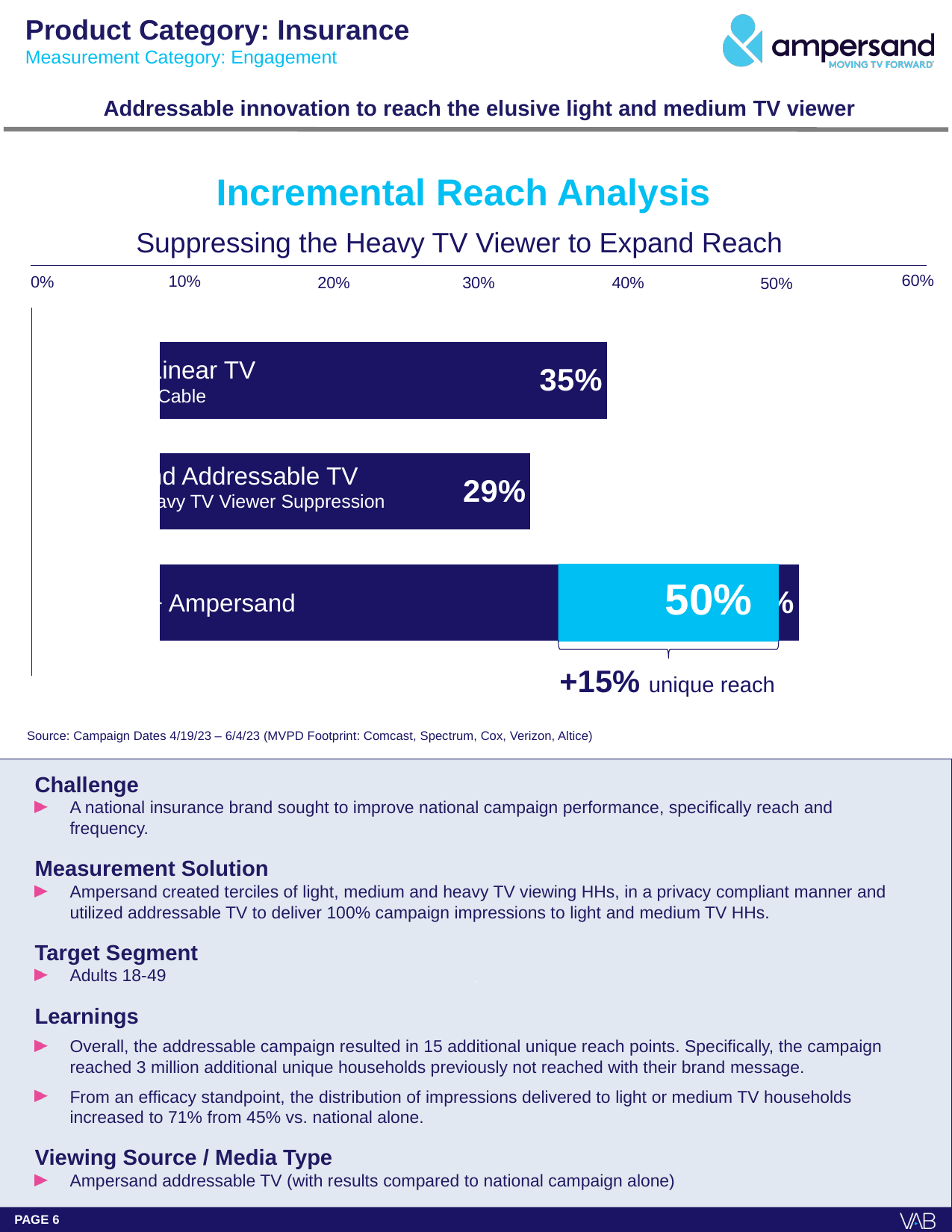
What is the difference between the Linear TV bar (35%) and the Addressable TV bar (29%)? 6% What kind of chart is shown on the slide? Bar chart What incremental unique reach is annotated below the Ampersand bar? +15% unique reach Is the value for the Ampersand bar greater or less than 40%? greater Which bar has the highest value? Ampersand What value is shown on the Addressable TV (Heavy TV Viewer Suppression) bar? 29% What value is shown on the Linear TV (Cable) bar? 35% How many bars are plotted in the chart? 3 What is the difference between the Ampersand bar (50%) and the Linear TV bar (35%)? 15% Which bar has the lowest value? Addressable TV (Heavy TV Viewer Suppression) Which is larger, the Linear TV bar or the Addressable TV bar? Linear TV What value is highlighted on the Ampersand bar? 50%